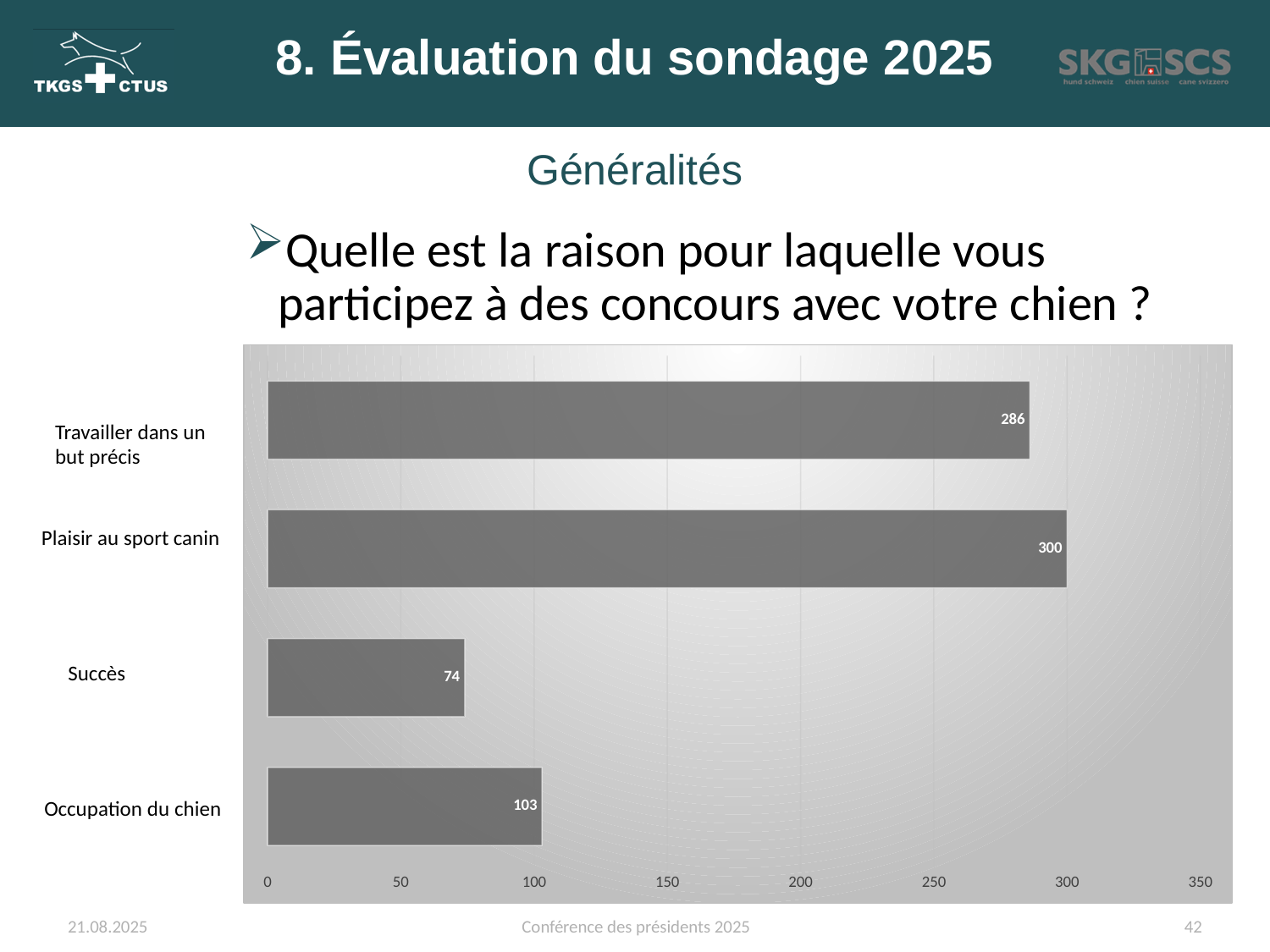
What is the value for "Succès"? 74 Is the value for "Travailler dans un but précis" greater or less than 250? greater How many categories are shown in the chart? 4 Which category has the lowest value? Succès What is the difference between the values for "Plaisir au sport canin" and "Travailler dans un but précis"? 14 What is the difference between the values for "Occupation du chien" and "Succès"? 29 What is the value for "Occupation du chien"? 103 Which is larger, the value for "Occupation du chien" or the value for "Succès"? Occupation du chien What is the value for "Plaisir au sport canin"? 300 What is the value for "Travailler dans un but précis"? 286 What kind of chart is shown on the slide? bar chart Which category has the highest value? Plaisir au sport canin